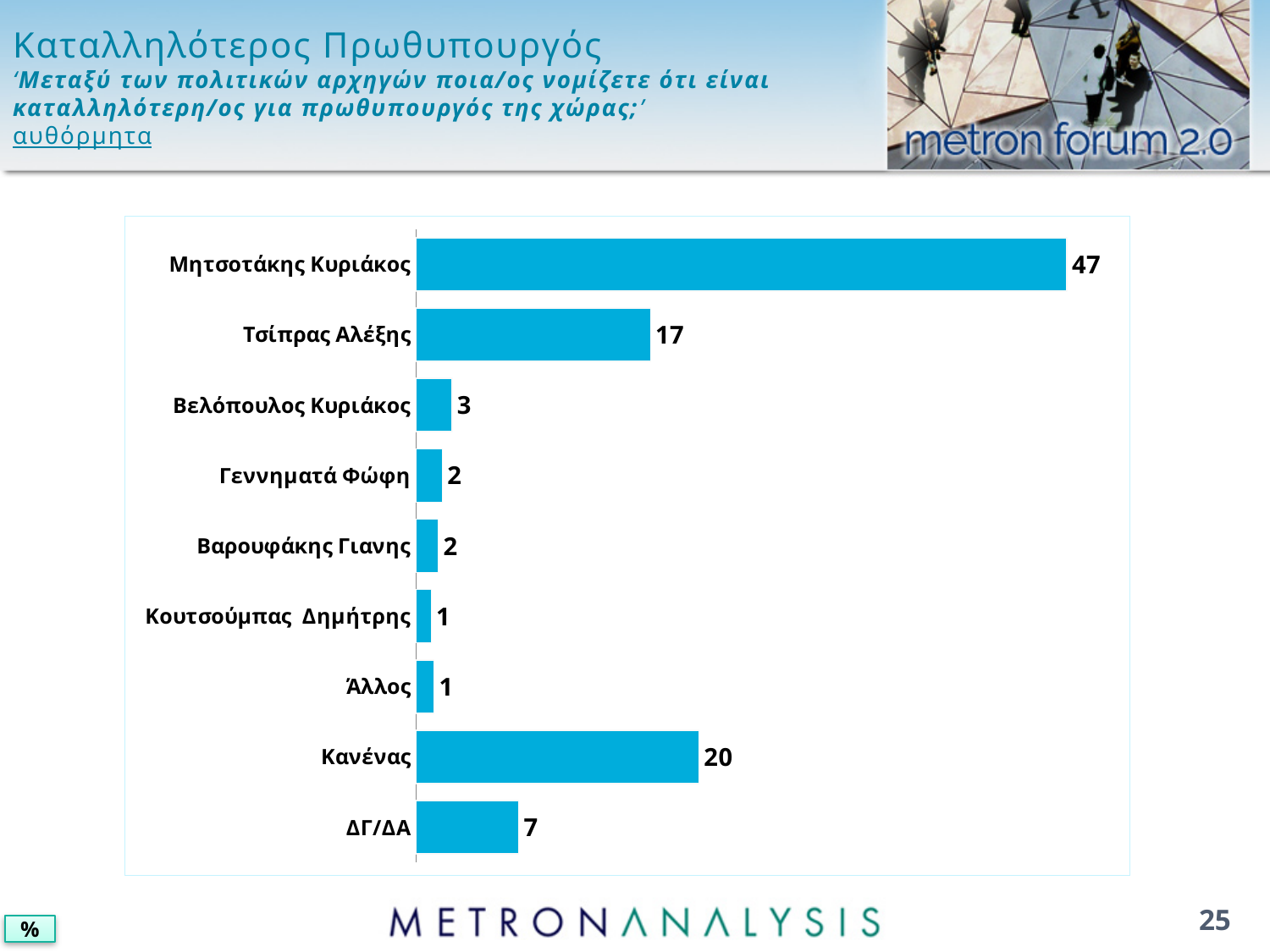
Which is larger, the value for Κανένας or the value for Τσίπρας Αλέξης? Κανένας What value is shown for Μητσοτάκης Κυριάκος? 47 What value is shown for ΔΓ/ΔΑ? 7 What value is shown for Κανένας? 20 What kind of chart is shown on the slide? bar chart How many categories are shown in the chart? 9 What is the difference between the values for Κανένας and ΔΓ/ΔΑ? 13 What value is shown for Τσίπρας Αλέξης? 17 What value is shown for Βελόπουλος Κυριάκος? 3 What is the title of the slide? Καταλληλότερος Πρωθυπουργός What is the difference between the values for Μητσοτάκης Κυριάκος and Τσίπρας Αλέξης? 30 Which category has the highest value? Μητσοτάκης Κυριάκος